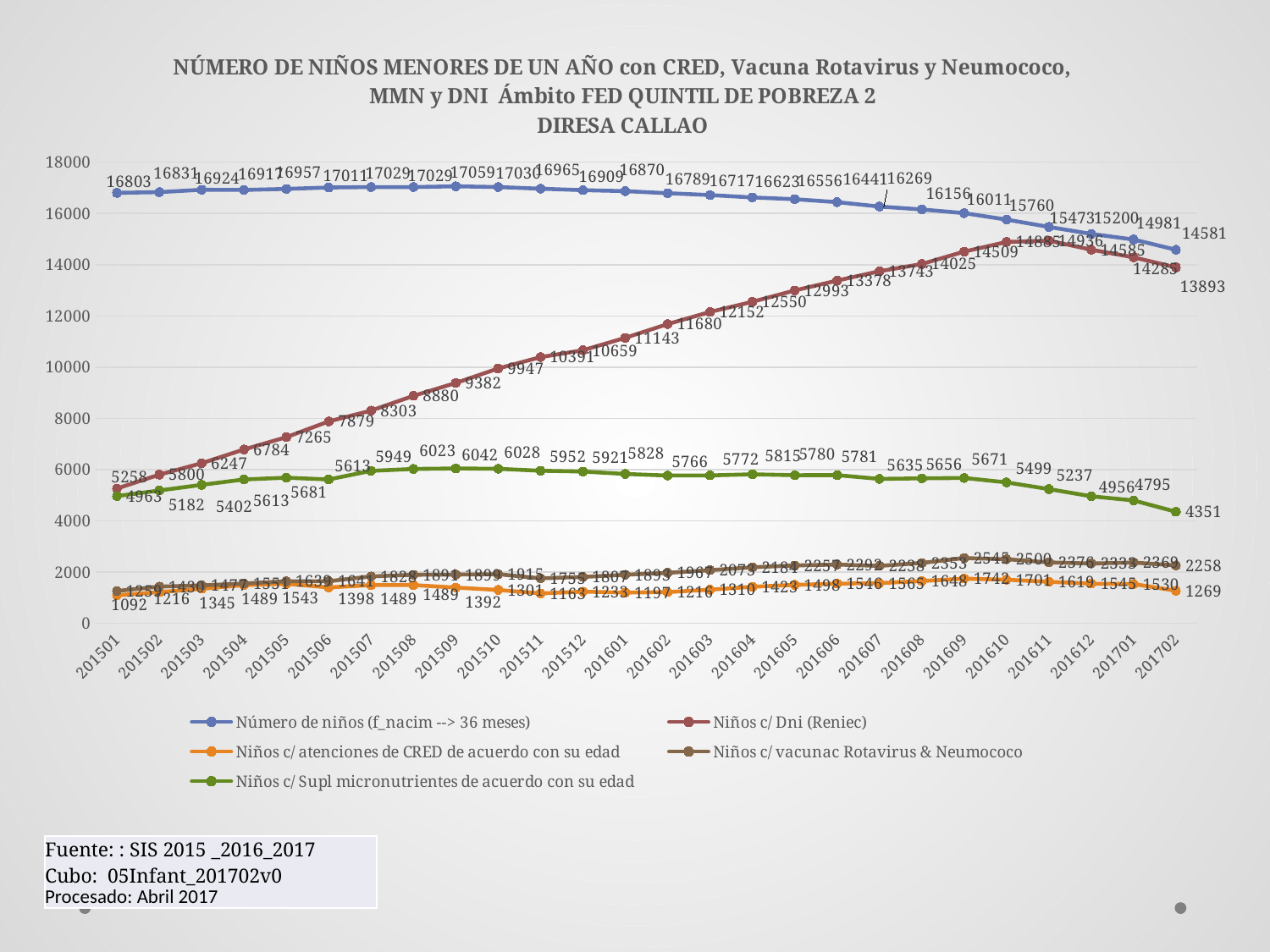
In which period does 'Niños c/ Supl micronutrientes de acuerdo con su edad' reach its highest value? 201509 Does the 'Niños c/ Dni (Reniec)' series rise or fall from 201501 to 201611? rise How many series does the legend list? 5 What is the value of 'Niños c/ Dni (Reniec)' for 201702? 13893 What is the value of 'Niños c/ Supl micronutrientes de acuerdo con su edad' for 201702? 4351 How many time periods are plotted along the x axis? 26 What is the difference between the 'Número de niños (f_nacim --> 36 meses)' values for 201501 and 201702? 2222 What is the highest value of 'Número de niños (f_nacim --> 36 meses)' shown on the chart? 17059 At 201702, which is larger: 'Número de niños (f_nacim --> 36 meses)' or 'Niños c/ Dni (Reniec)'? Número de niños (f_nacim --> 36 meses) What is the value of 'Número de niños (f_nacim --> 36 meses)' for 201501? 16803 What is the value of 'Número de niños (f_nacim --> 36 meses)' for 201702? 14581 What kind of chart is shown on the slide? line chart